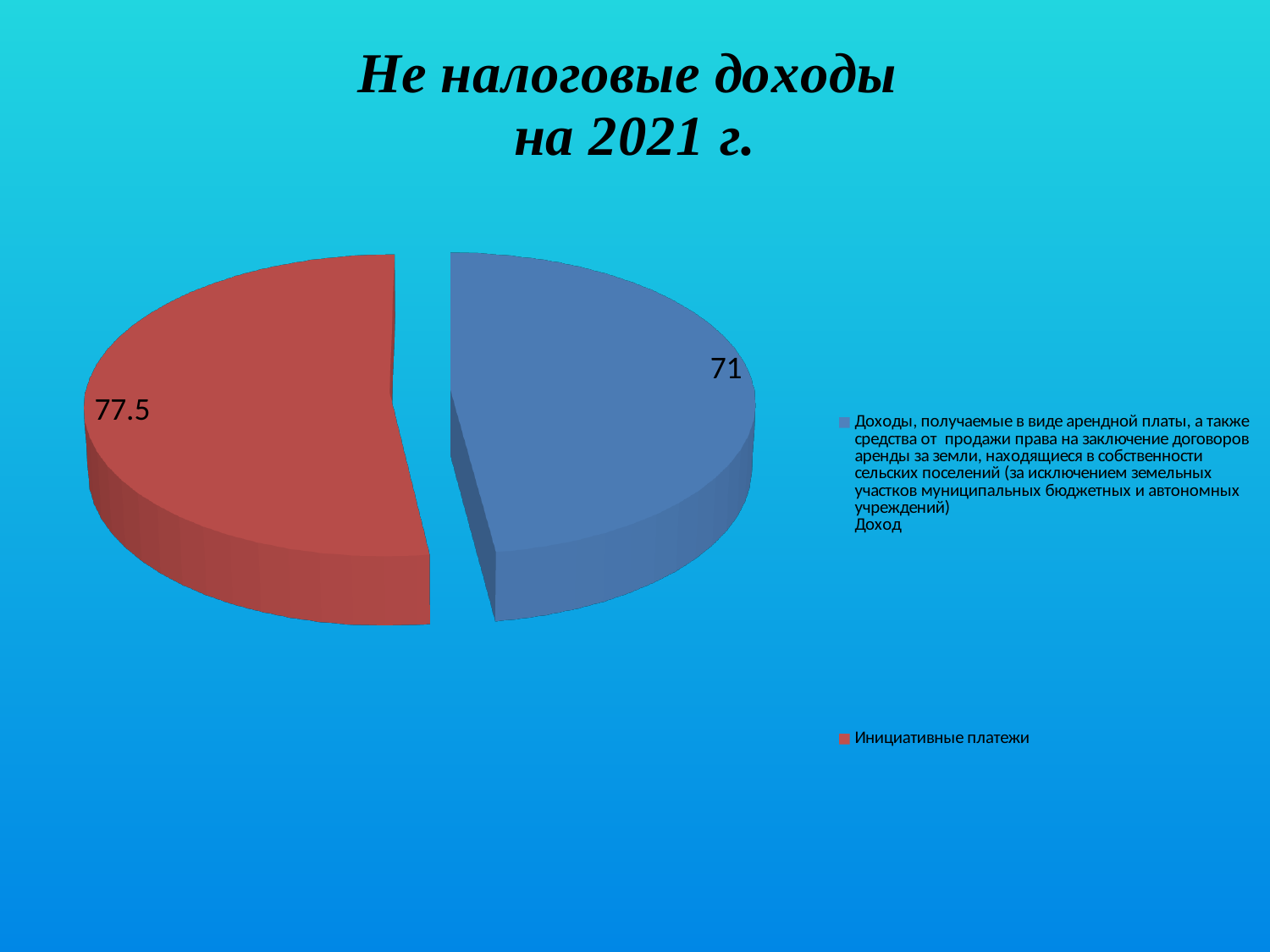
What is the value shown for Инициативные платежи? 77.5 What is the title of the slide? Не налоговые доходы на 2021 г. What is the difference between the value for Инициативные платежи and the value for the rental income slice (Доходы, получаемые в виде арендной платы...)? 6.5 How many entries does the legend list? 2 What colour is the slice for Инициативные платежи? Red How many slices does the pie chart have? 2 What kind of chart is shown on the slide? Pie chart Which category has the largest slice in the pie chart? Инициативные платежи What is the value shown for the slice 'Доходы, получаемые в виде арендной платы...' (the blue slice)? 71 Which category has the smallest slice in the pie chart? Доходы, получаемые в виде арендной платы, а также средства от продажи права на заключение договоров аренды за земли Which is larger: the value for Инициативные платежи or the value for the rental income slice (Доходы, получаемые в виде арендной платы...)? Инициативные платежи What is the total of the two values shown in the pie chart? 148.5